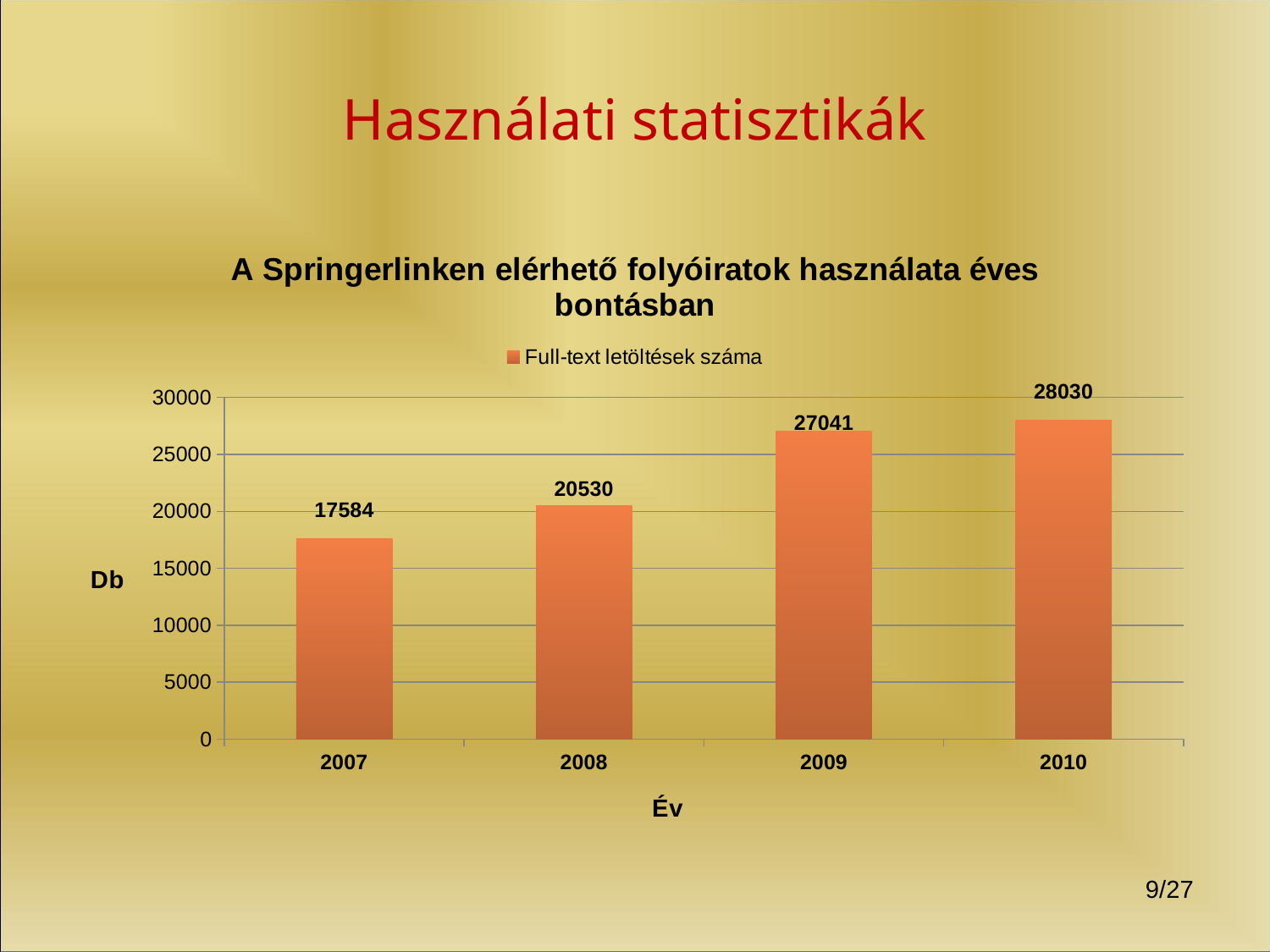
What is the difference between the values for 2008 and 2007? 2946 Which year has the highest value? 2010 How many years are shown on the x axis? 4 What is the value for 2009? 27041 What is the value for 2010? 28030 What kind of chart is shown? bar chart Which is larger, the value for 2008 or the value for 2009? 2009 Is the value for 2008 greater or less than 25000? less Which year has the lowest value? 2007 What is the value for 2007? 17584 What is the difference between the values for 2010 and 2009? 989 Do the values rise or fall from 2007 to 2010? rise